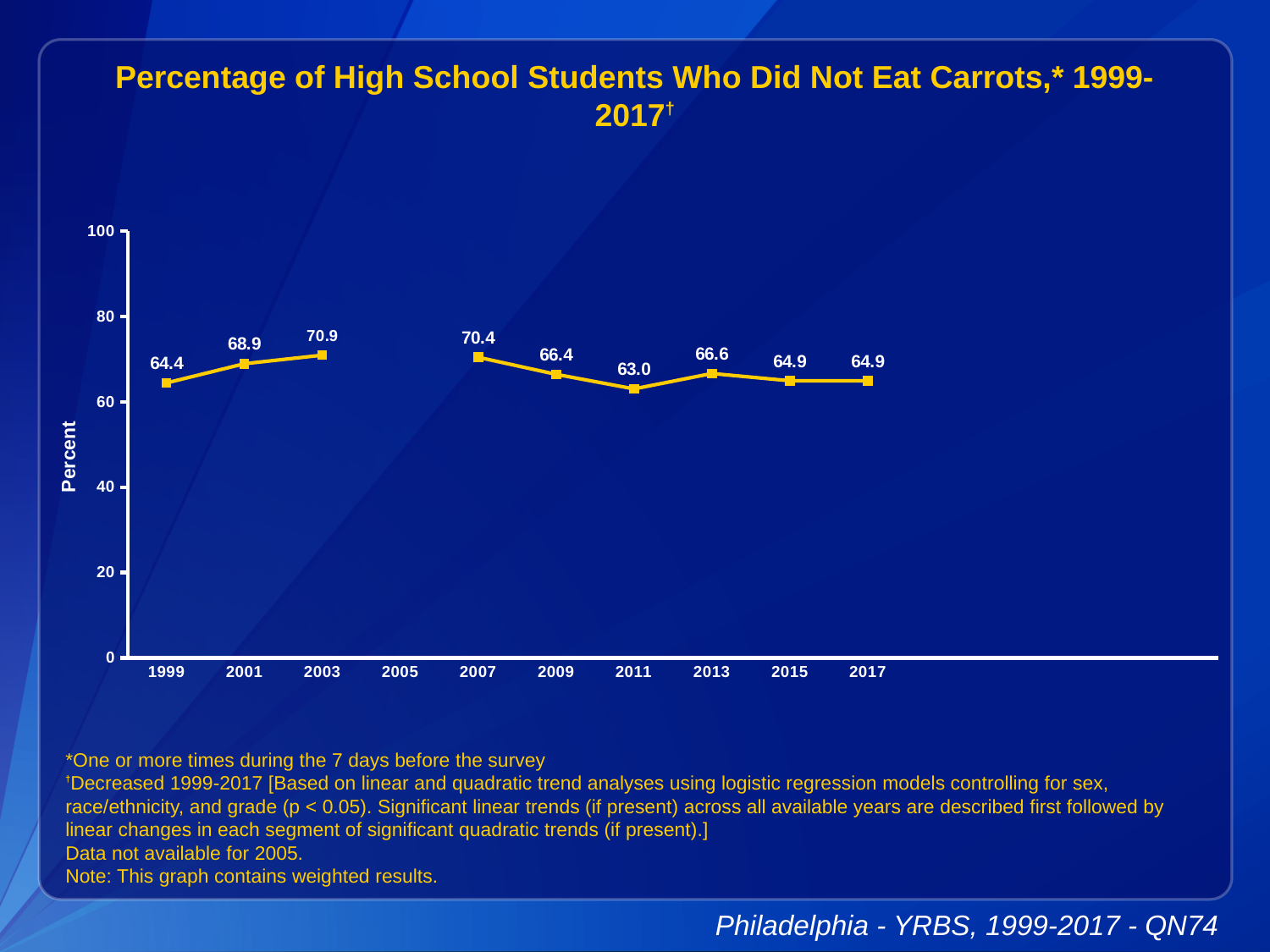
What kind of chart is shown on the slide? Line chart What percentage of high school students did not eat carrots in 1999? 64.4 What is the difference between the values for 2003 and 2011? 7.9 What is the value plotted for 2011? 63.0 Do the values rise or fall from 1999 to 2003? Rise What is the value plotted for 2017? 64.9 Which year has a larger value, 2007 or 2009? 2007 Which year has the lowest percentage of students who did not eat carrots? 2011 Is the value for 2013 greater or less than 60? greater What is the difference between the values for 1999 and 2001? 4.5 Which year has the highest percentage of students who did not eat carrots? 2003 How many years have data points plotted on the chart? 9